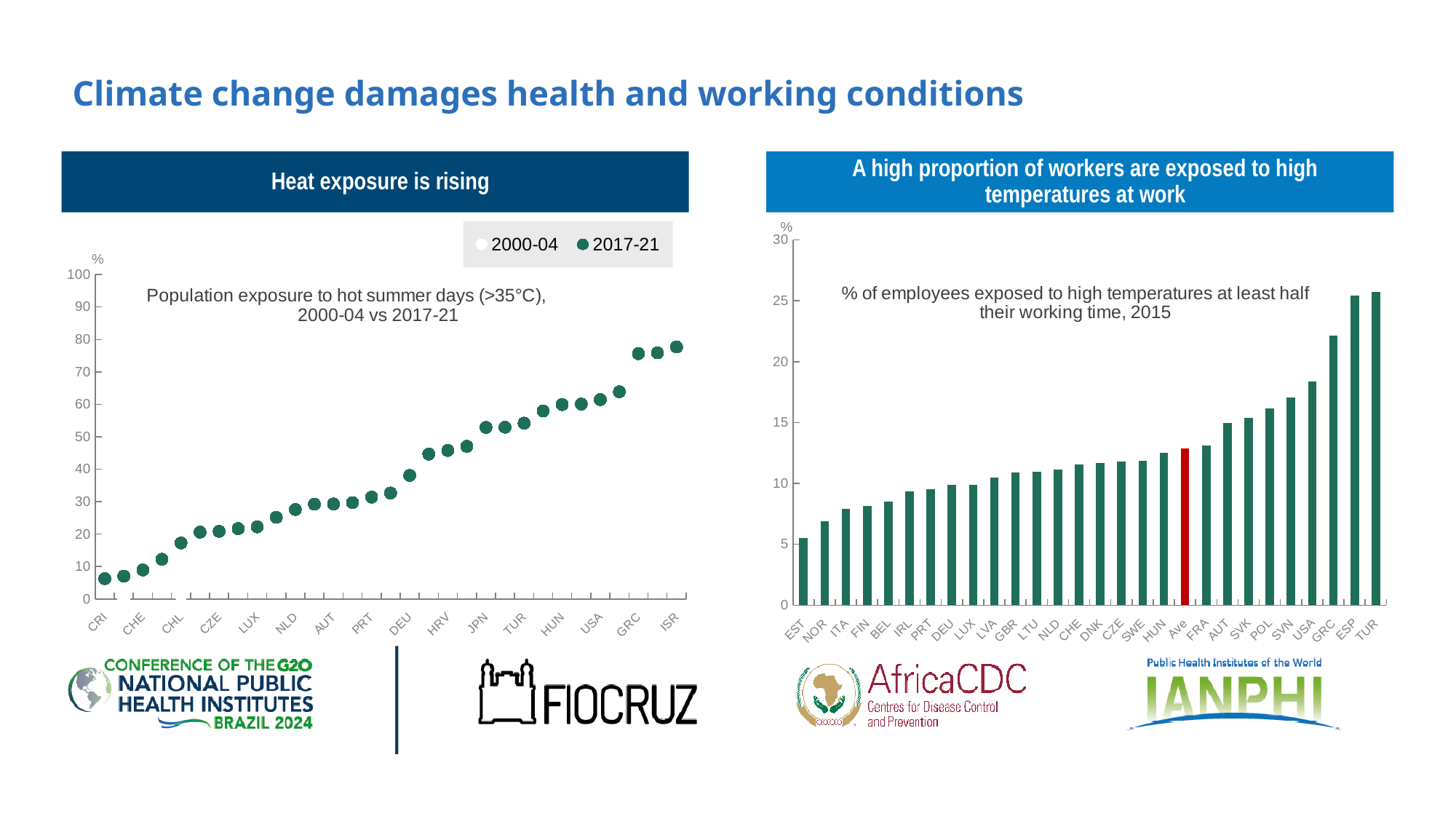
In the 'A high proportion of workers are exposed to high temperatures at work' chart, which country has the lowest value? EST In the 'A high proportion of workers are exposed to high temperatures at work' chart, which bar is coloured red? Ave In the 'Heat exposure is rising' chart, which labelled country has the lowest 2017-21 value? CRI In the 'A high proportion of workers are exposed to high temperatures at work' chart, is the value for GRC greater or less than 20? greater In the 'Heat exposure is rising' chart, do the 2017-21 values rise or fall from left to right along the x axis? rise In the 'Heat exposure is rising' chart, is the 2017-21 value for CHL greater or less than 20? less In the 'Heat exposure is rising' chart, which labelled country has the highest 2017-21 value? ISR What kind of chart is the 'A high proportion of workers are exposed to high temperatures at work' chart? bar chart In the 'A high proportion of workers are exposed to high temperatures at work' chart, which is larger, the value for USA or the value for NOR? USA In the 'Heat exposure is rising' chart, how many series does the legend list? 2 In the 'Heat exposure is rising' chart, is the 2017-21 value for ISR greater or less than 70? greater In the 'A high proportion of workers are exposed to high temperatures at work' chart, which country has the highest value? TUR